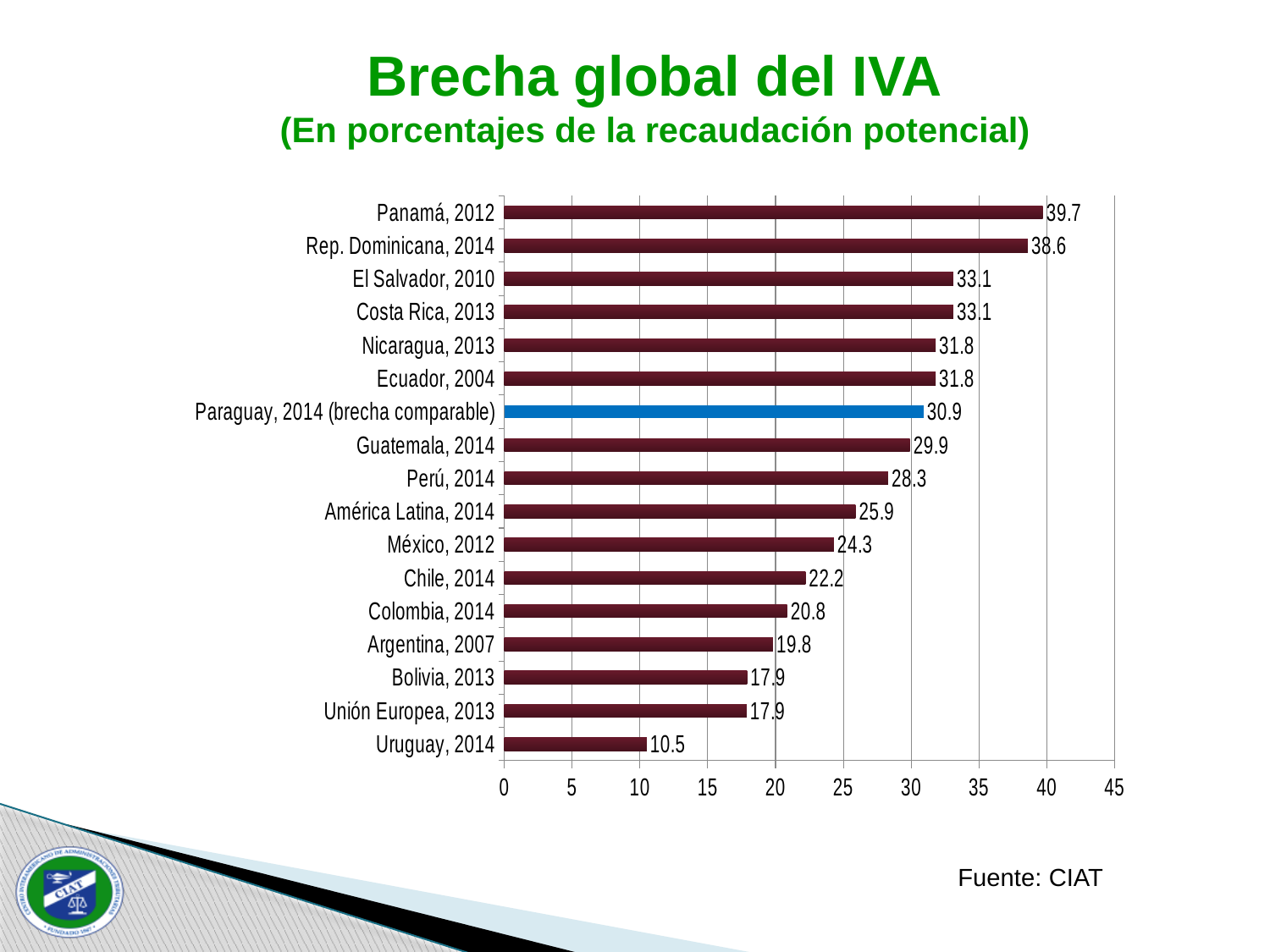
What is the difference between the values for Panamá, 2012 and Rep. Dominicana, 2014? 1.1 Is the value for México, 2012 greater or less than 25? less What kind of chart is shown on the slide? Bar chart What is the value for Panamá, 2012? 39.7 Which bar is shown in a different colour (blue) from the others? Paraguay, 2014 (brecha comparable) What is the value for Uruguay, 2014? 10.5 What is the value for Paraguay, 2014 (brecha comparable)? 30.9 Which is larger, the value for Chile, 2014 or the value for Colombia, 2014? Chile, 2014 How many categories are shown in the chart? 17 What is the difference between the values for América Latina, 2014 and Unión Europea, 2013? 8.0 Which category has the lowest value? Uruguay, 2014 Which category has the highest value? Panamá, 2012